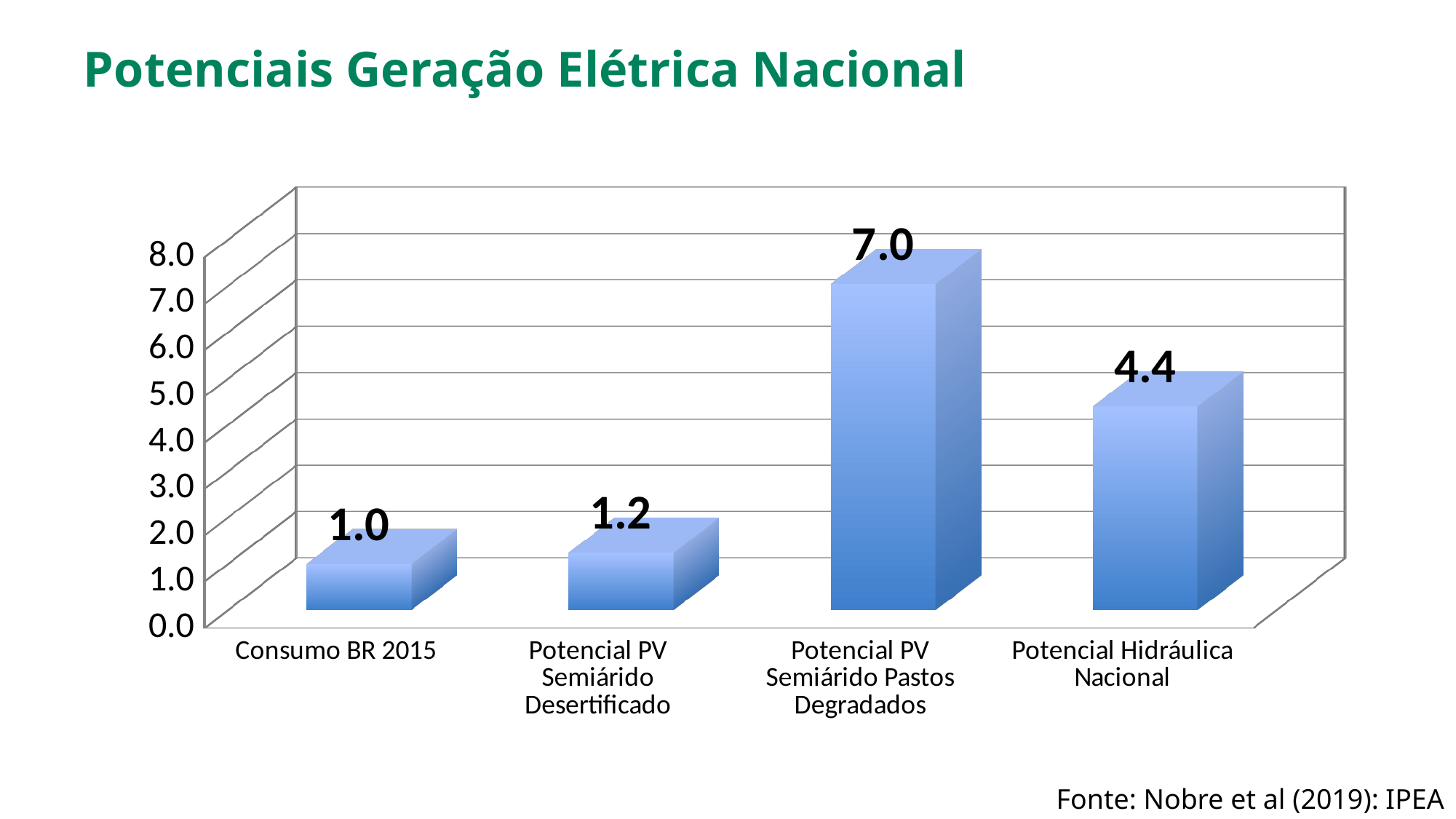
What is the value for Consumo BR 2015? 1.0 Which is larger, the value for Potencial Hidráulica Nacional or the value for Potencial PV Semiárido Desertificado? Potencial Hidráulica Nacional What kind of chart is shown on the slide? bar chart Is the value for Potencial Hidráulica Nacional greater or less than 5.0? less What is the value for Potencial PV Semiárido Desertificado? 1.2 What is the difference between the values for Potencial PV Semiárido Pastos Degradados and Potencial Hidráulica Nacional? 2.6 How many categories are shown in the chart? 4 Which category has the lowest value? Consumo BR 2015 What is the value for Potencial PV Semiárido Pastos Degradados? 7.0 Which category has the highest value? Potencial PV Semiárido Pastos Degradados What is the value for Potencial Hidráulica Nacional? 4.4 What is the title of the slide? Potenciais Geração Elétrica Nacional